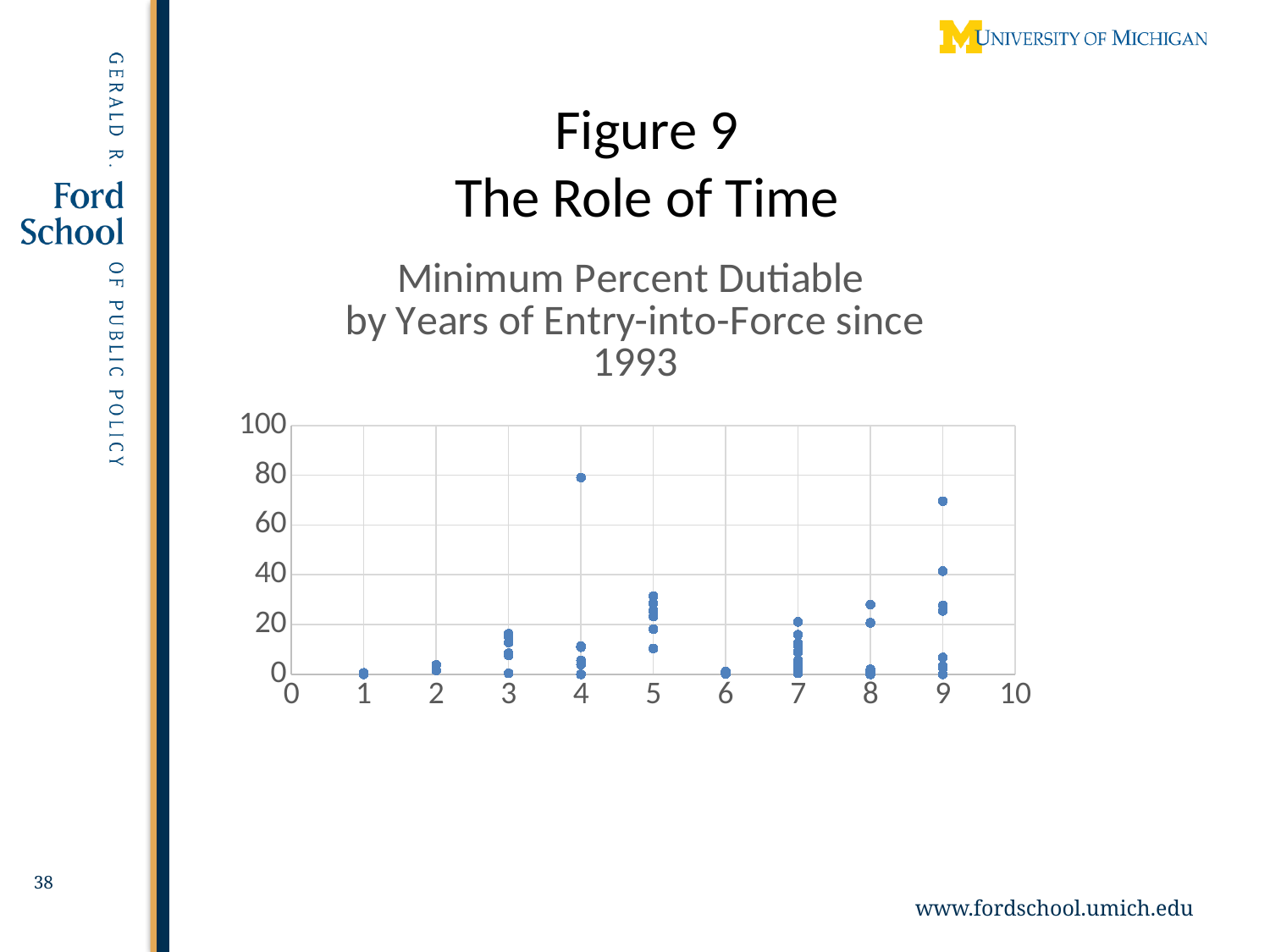
What kind of chart is shown on the slide? scatter chart Is the highest point plotted at x = 4 greater or less than 60? greater Is the highest point plotted at x = 9 greater or less than 60? greater What is the title of the chart? Minimum Percent Dutiable by Years of Entry-into-Force since 1993 Are the points plotted at x = 1 greater or less than 20? less How many distinct x values (years) have points plotted on the chart? 9 At which x value does the single highest point on the chart appear? 4 What is the highest value shown on the vertical axis of the chart? 100